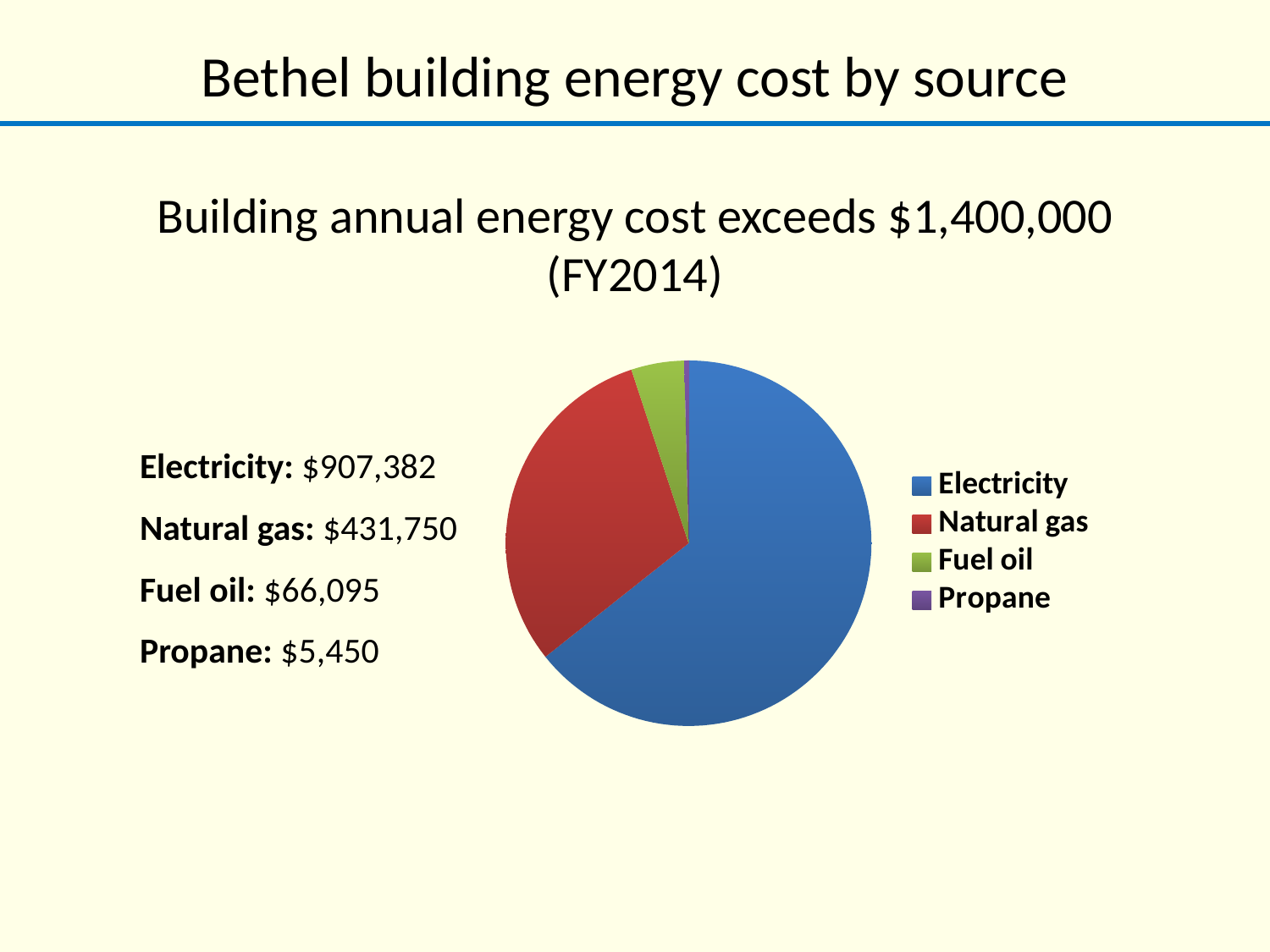
How many entries does the legend of the pie chart list? 4 What is the annual energy cost for Propane? $5,450 Which colour represents Fuel oil in the pie chart? green Which costs more, Natural gas or Fuel oil? Natural gas Which energy source has the smallest share of the pie chart? Propane Which energy source has the largest share of the pie chart? Electricity How many energy sources (slices) does the pie chart show? 4 How much more does Electricity cost than Natural gas? $475,632 What is the annual energy cost for Electricity? $907,382 What is the annual energy cost for Fuel oil? $66,095 What is the annual energy cost for Natural gas? $431,750 What kind of chart is shown on the slide? pie chart